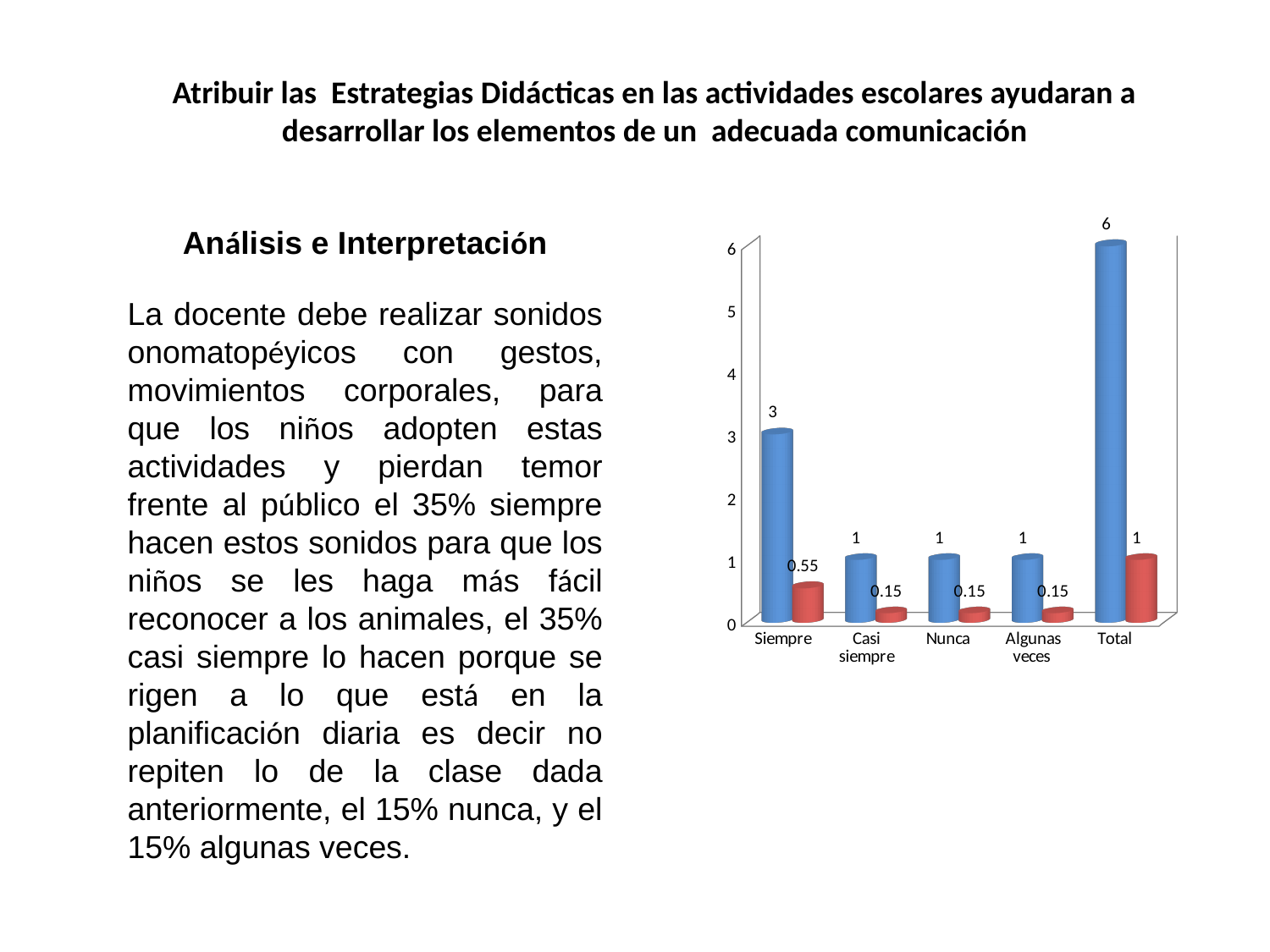
What is the difference between the blue bar for Total and the blue bar for Siempre? 3 What is the value of the red bar for Nunca? 0.15 What type of chart is shown on the slide? bar chart What is the value of the blue bar for Siempre? 3 How many categories are shown on the x axis of the chart? 5 What colours are the two series of bars in the chart? blue and red What is the value of the blue bar for Total? 6 What is the value of the red bar for Siempre? 0.55 What is the difference between the red bar for Total and the red bar for Algunas veces? 0.85 Which is larger, the red bar for Siempre or the red bar for Casi siempre? Siempre Is the blue bar for Total greater or less than 5? greater Which category has the highest blue bar? Total